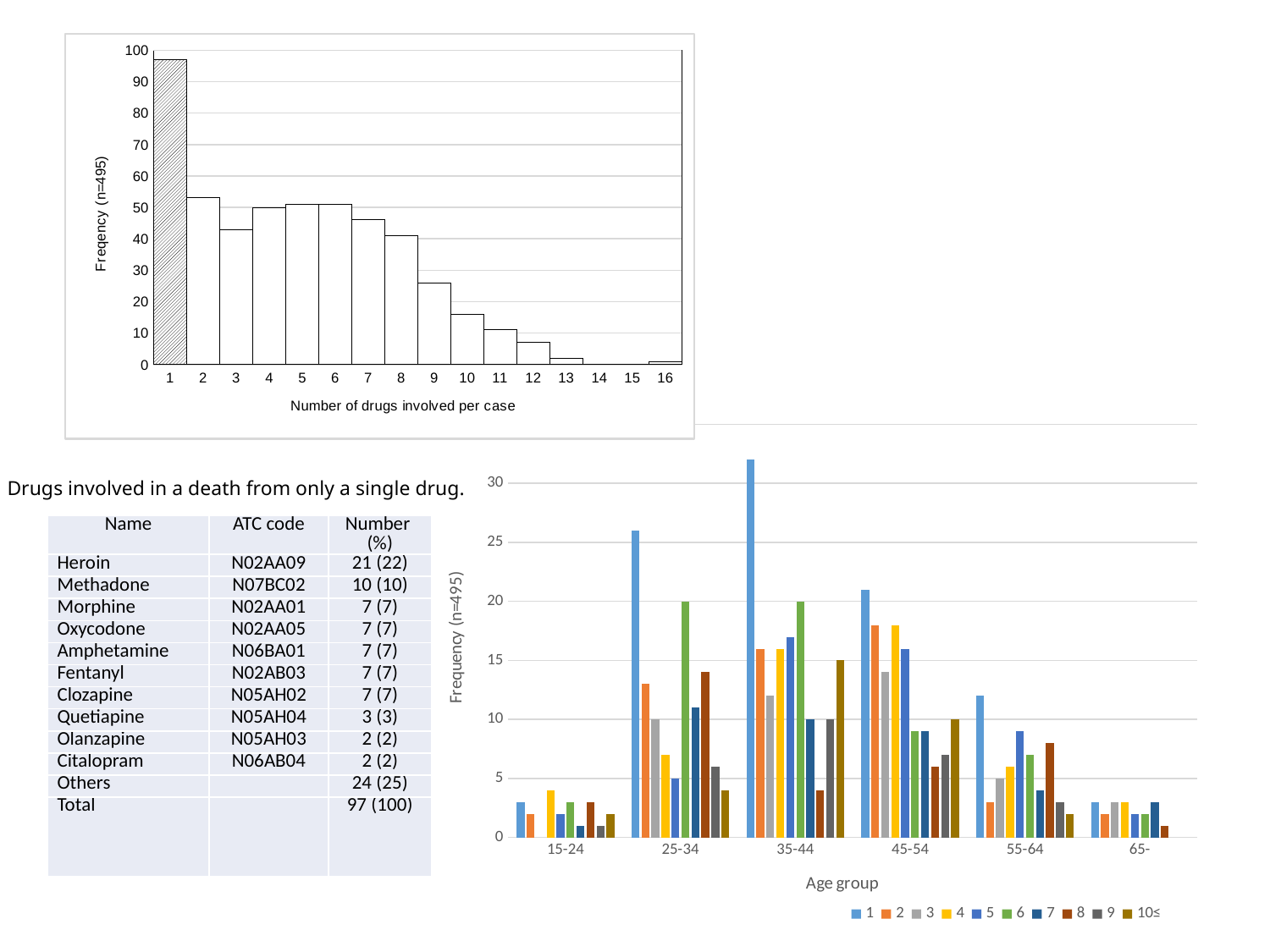
What kind of chart is the top-left chart titled 'Number of drugs involved per case'? bar chart How many series does the legend of the bottom-right chart (Age group) list? 10 How many age groups are shown on the x axis of the bottom-right chart (Age group)? 6 In the bottom-right chart (Age group), which age group has the highest bar for series 1? 35-44 In the top-left chart (Number of drugs involved per case), is the frequency for 1 drug greater or less than 90? greater How many categories are shown on the x axis of the top-left chart (Number of drugs involved per case)? 16 In the top-left chart (Number of drugs involved per case), do the frequencies generally rise or fall from 8 drugs to 13 drugs? fall In the top-left chart (Number of drugs involved per case), is the frequency for 9 drugs greater or less than 30? less What is the x-axis label of the bottom-right chart? Age group In the top-left chart (Number of drugs involved per case), which has a higher frequency: 2 drugs or 3 drugs? 2 drugs In the top-left chart (Number of drugs involved per case), which number of drugs has the highest frequency? 1 In the bottom-right chart (Age group), is the value for series 1 in the 35-44 age group greater or less than 30? greater